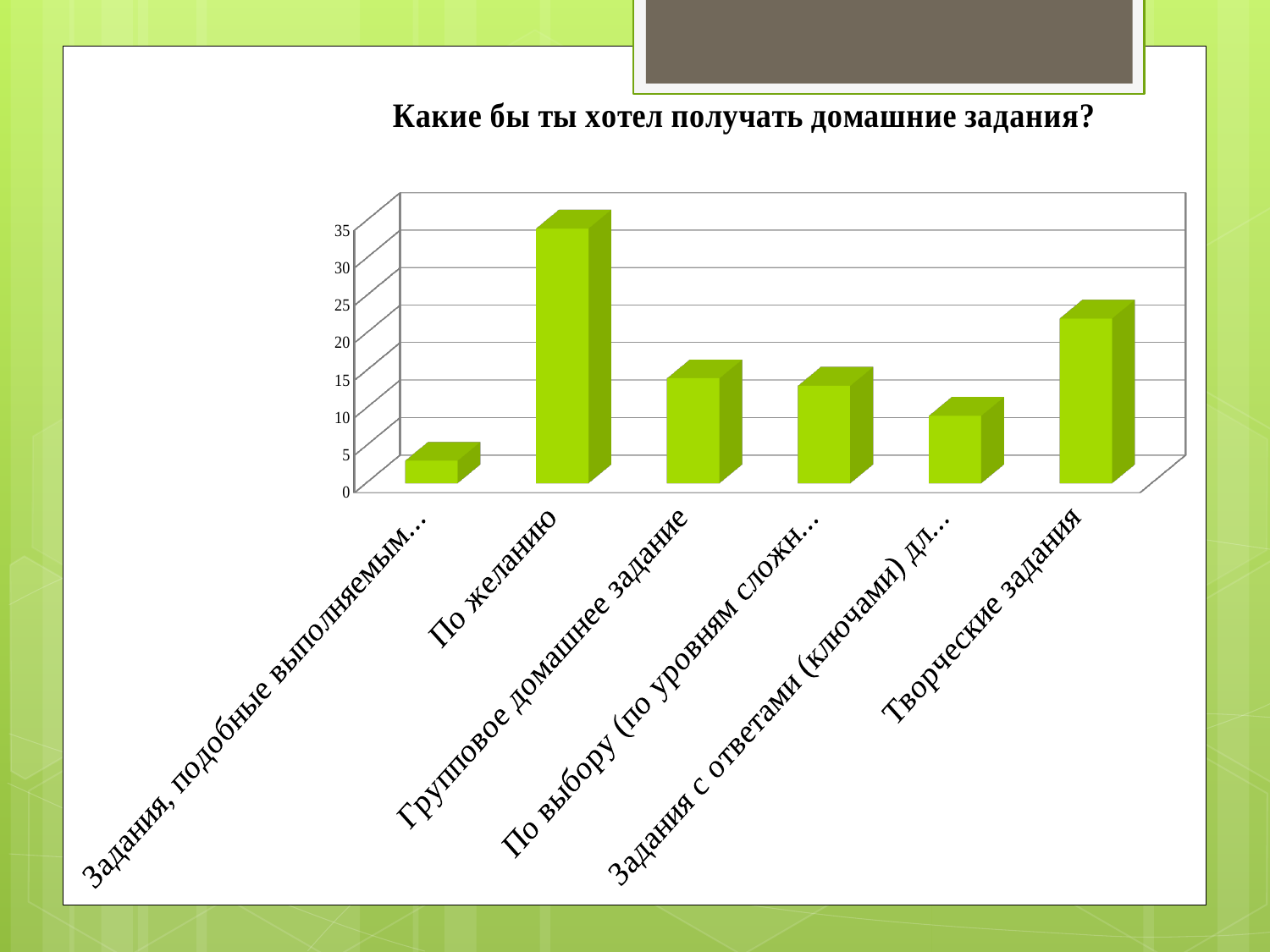
Is the value for Задания с ответами (ключами) дл... greater or less than 15? less What kind of chart is shown on the slide? bar chart What is the title of the chart? Какие бы ты хотел получать домашние задания? Which category has the highest value? По желанию Is the value for По желанию greater or less than 30? greater How many categories are shown on the x axis of the chart? 6 Which category has the lowest value? Задания, подобные выполняемым... Which is larger, the value for По желанию or the value for Творческие задания? По желанию Which is larger, the value for Творческие задания or the value for Групповое домашнее задание? Творческие задания Is the value for Групповое домашнее задание greater or less than 10? greater